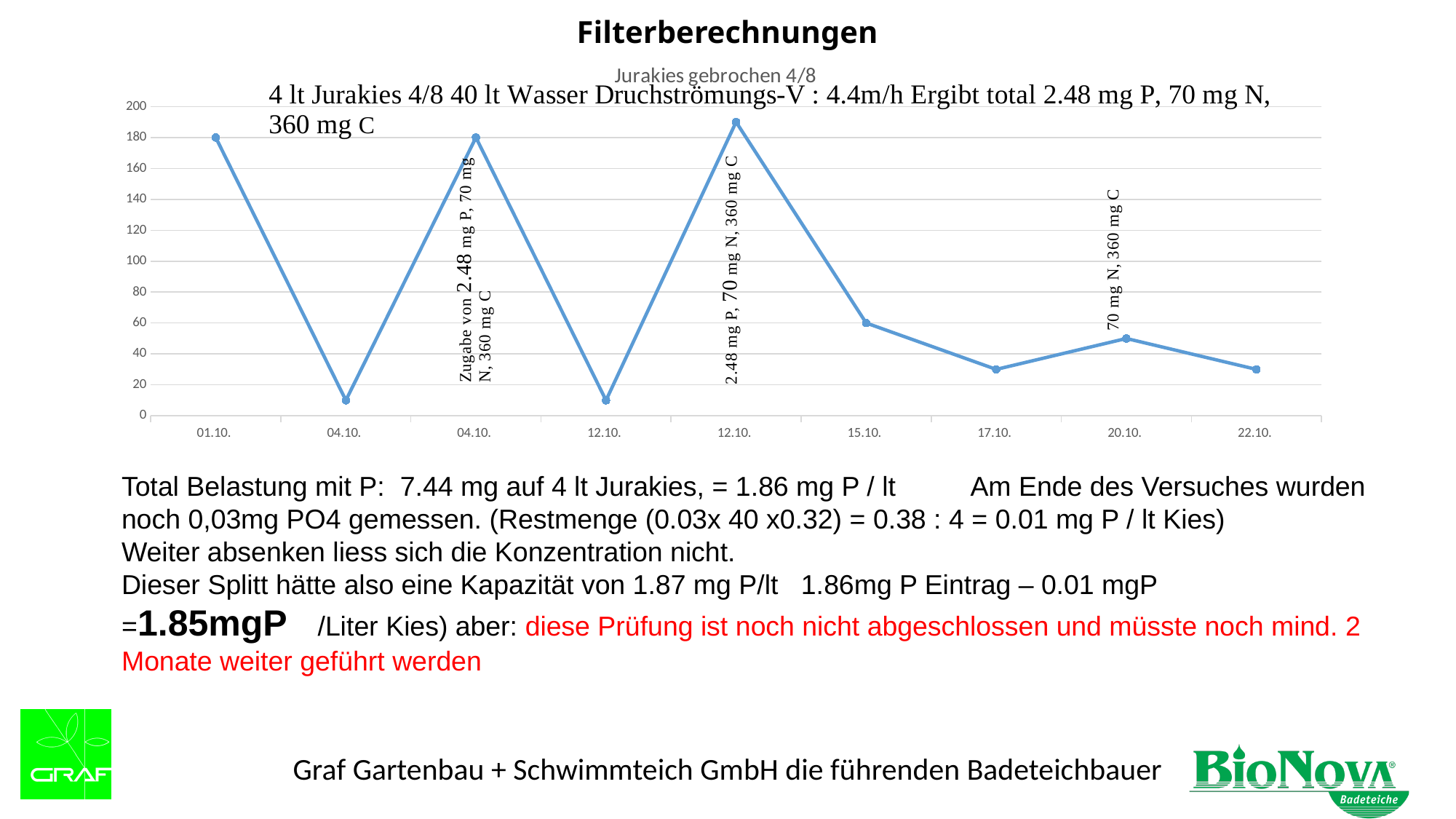
Which has the larger value, 15.10. or 17.10.? 15.10. What is the value plotted for 01.10.? 180 What is the title of the chart? Jurakies gebrochen 4/8 Is the value for 17.10. greater or less than 40? less Is the value for 20.10. greater or less than 40? greater What type of chart is shown on the slide? line chart What is the value plotted for 15.10.? 60 What is the last date label on the x axis? 22.10. Is the value for 22.10. greater or less than 40? less What is the difference between the values for 01.10. and 15.10.? 120 How many data points are plotted on the chart? 9